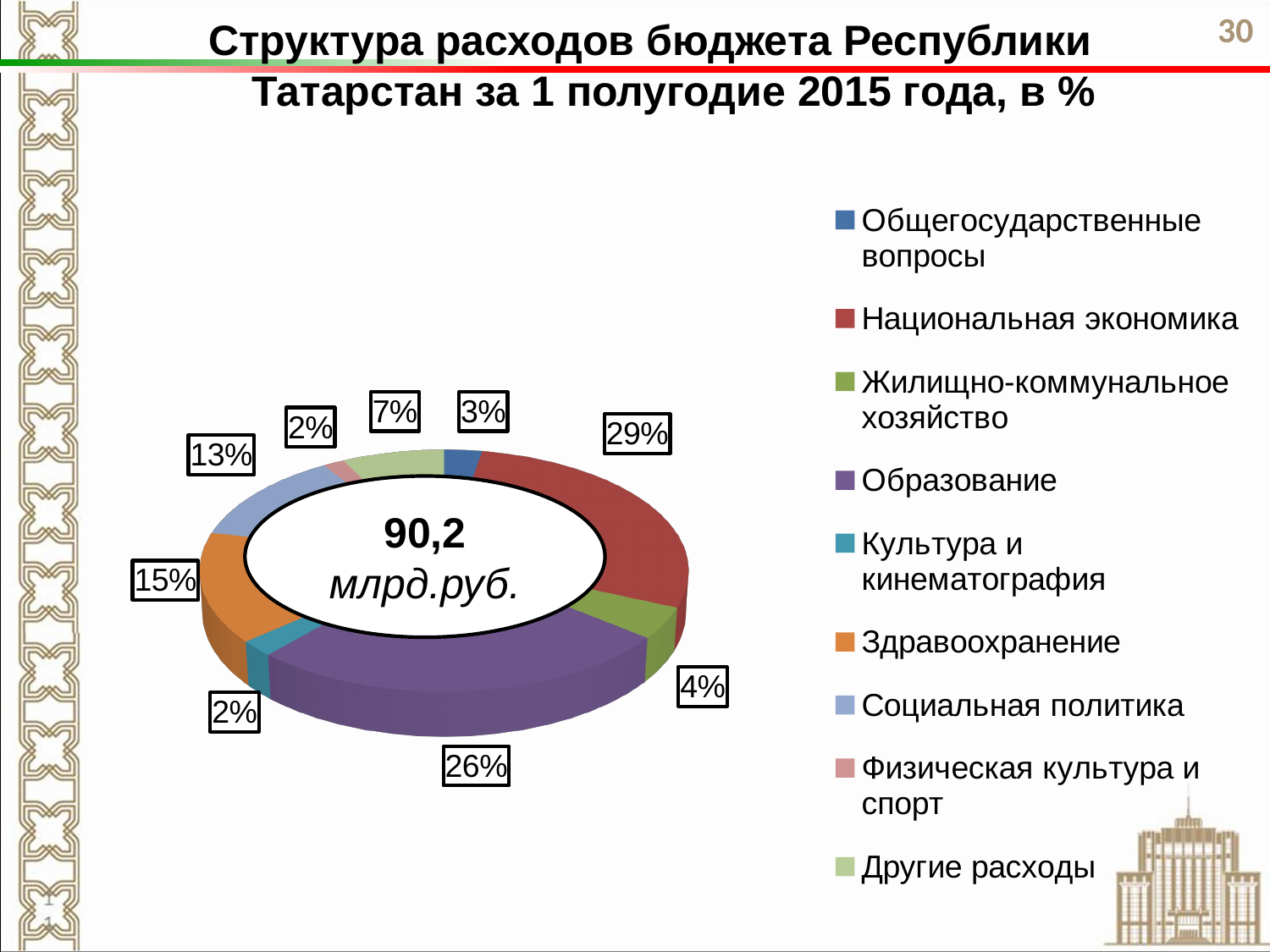
What share of expenditures does Общегосударственные вопросы account for? 3% Which is larger: the share for Здравоохранение or the share for Социальная политика? Здравоохранение What total amount is written in the centre of the chart? 90,2 млрд.руб. What share of expenditures does Социальная политика account for? 13% What share of expenditures does Другие расходы account for? 7% How many categories does the legend list? 9 What share of expenditures does Образование account for? 26% What is the difference in percentage points between Национальная экономика and Образование? 3 What share of expenditures does Здравоохранение account for? 15% Which category has the largest share of the budget expenditures? Национальная экономика What share of expenditures does Национальная экономика account for? 29% What kind of chart is shown on the slide? doughnut (pie) chart